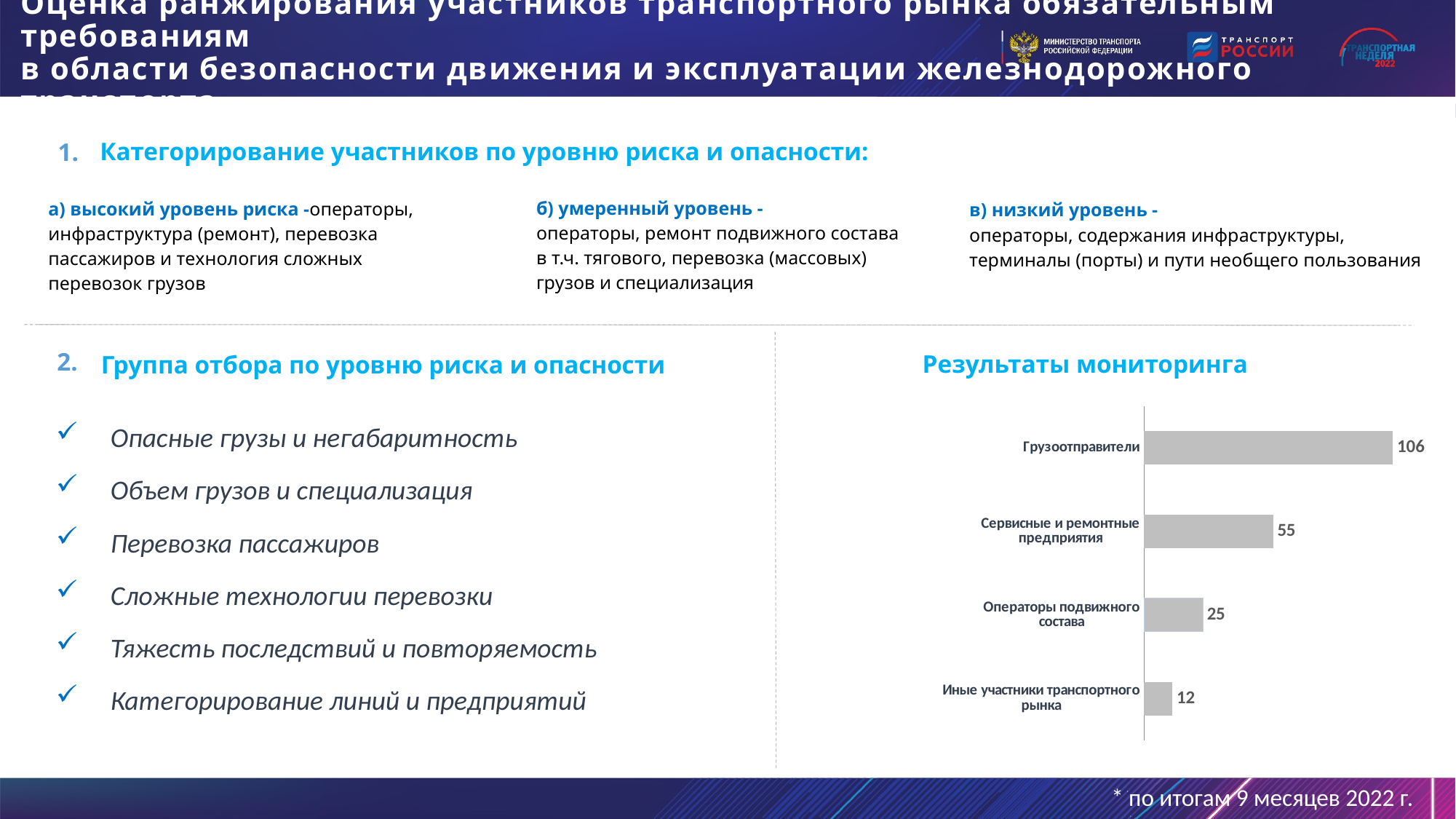
Which category has the highest value? Грузоотправители What is the difference between the values for Грузоотправители and Сервисные и ремонтные предприятия? 51 What kind of chart is shown on the slide? bar chart What is the difference between the values for Операторы подвижного состава and Иные участники транспортного рынка? 13 What is the value for Иные участники транспортного рынка? 12 What is the value for Операторы подвижного состава? 25 Which category has the lowest value? Иные участники транспортного рынка What is the value for Грузоотправители? 106 What is the title above the chart? Результаты мониторинга How many categories are shown in the chart? 4 What is the value for Сервисные и ремонтные предприятия? 55 Which is larger: the value for Сервисные и ремонтные предприятия or the value for Операторы подвижного состава? Сервисные и ремонтные предприятия